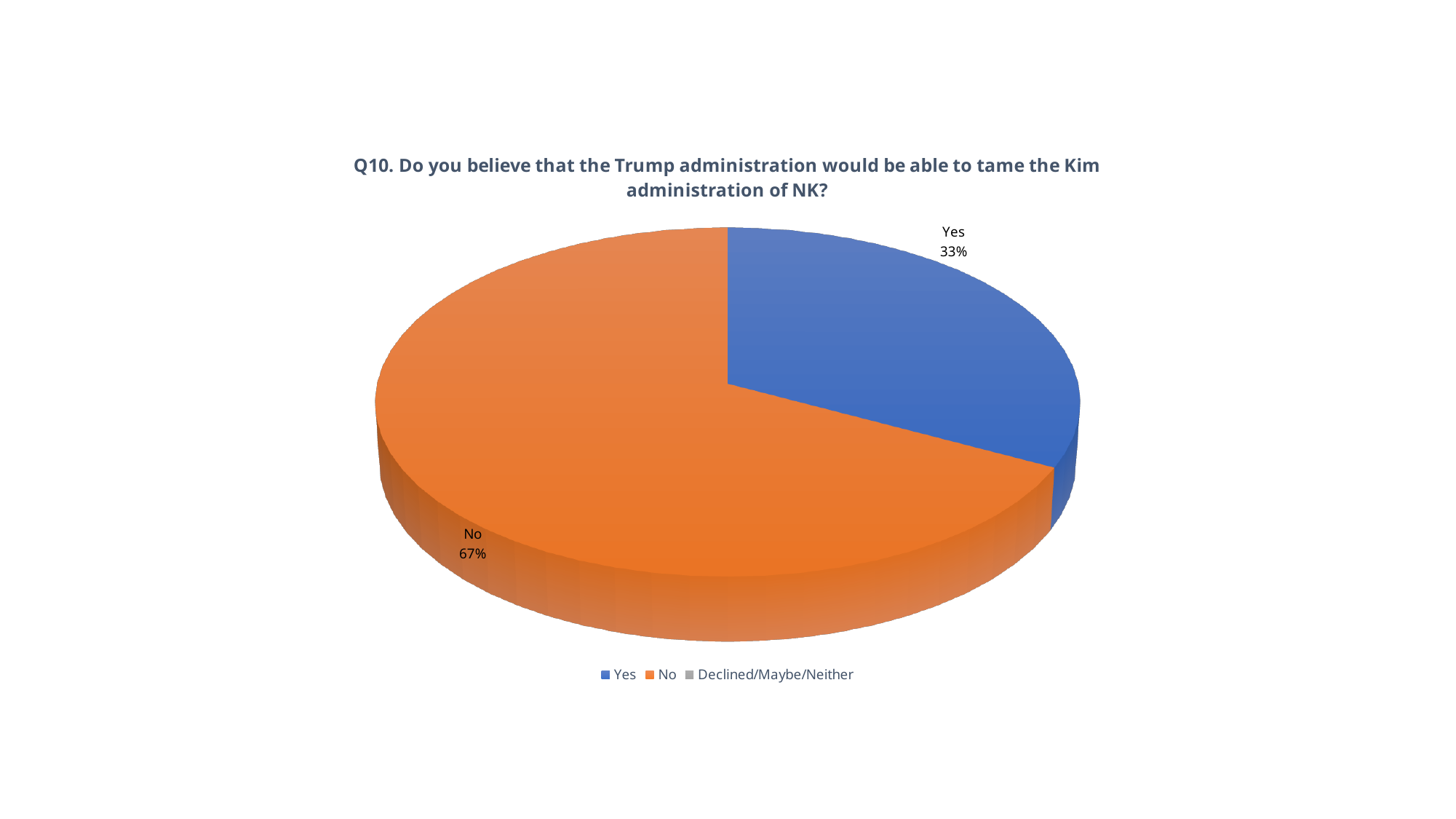
How many slices are visibly labelled with a percentage on the pie? 2 How many entries does the legend list? 3 What percentage of respondents answered "No"? 67% What colour is the "No" slice? orange What kind of chart is shown on the slide? pie chart Which response has the largest share of the pie? No Is the share for "No" larger or smaller than the share for "Yes"? larger Which of the two labelled slices, Yes or No, is smaller? Yes What is the third legend entry, after Yes and No? Declined/Maybe/Neither What percentage of respondents answered "Yes"? 33% What is the difference in percentage points between the "No" and "Yes" slices? 34